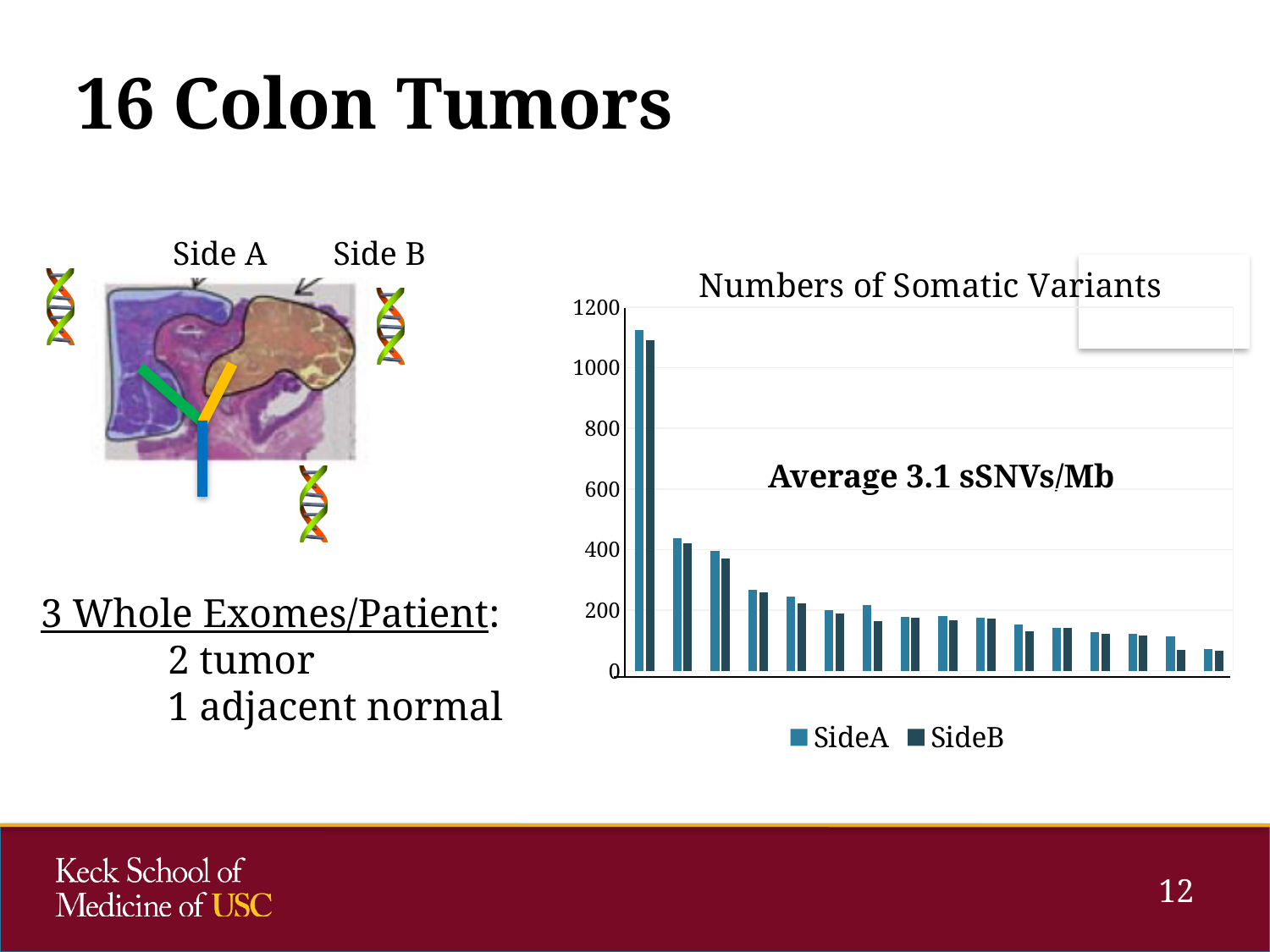
How many series does the legend of the "Numbers of Somatic Variants" chart list? 2 What kind of chart is shown under the title "Numbers of Somatic Variants"? bar chart What is the maximum value shown on the y axis of the "Numbers of Somatic Variants" chart? 1200 Is the SideB value for the leftmost tumor in the "Numbers of Somatic Variants" chart greater or less than 1000? greater What are the two series named in the legend of the "Numbers of Somatic Variants" chart? SideA and SideB Do the bar heights in the "Numbers of Somatic Variants" chart rise or fall from left to right? fall Is the SideA value for the second tumor from the left in the "Numbers of Somatic Variants" chart greater or less than 600? less Is the SideA value for the leftmost tumor in the "Numbers of Somatic Variants" chart greater or less than 1000? greater Which tumor group has the lowest values in the "Numbers of Somatic Variants" chart? the rightmost group Which tumor group has the highest values in the "Numbers of Somatic Variants" chart? the leftmost group How many tumor groups (pairs of bars) are plotted in the "Numbers of Somatic Variants" chart? 16